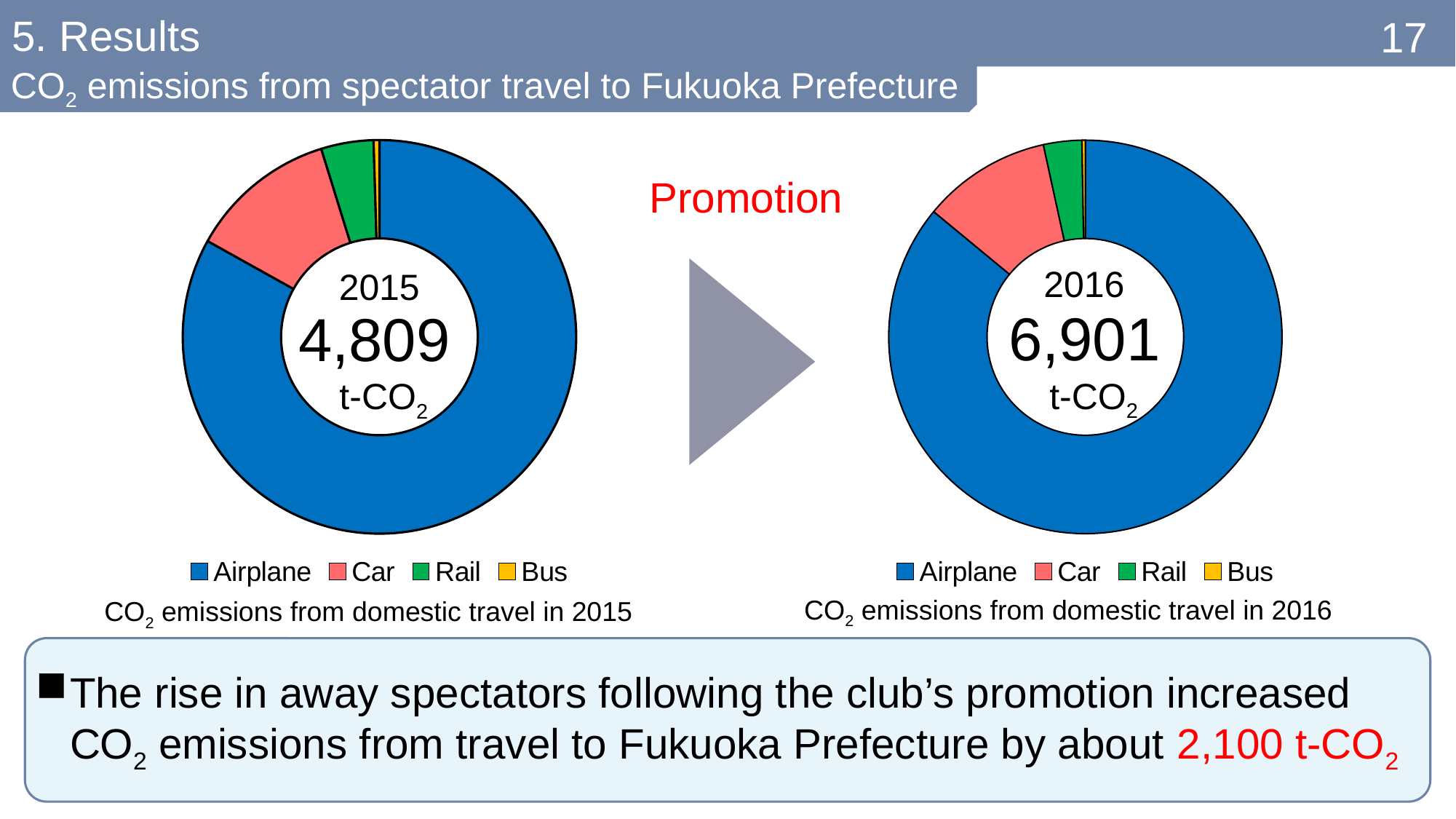
Did total CO2 emissions from domestic travel rise or fall from 2015 to 2016? Rise In the 2016 chart, which has the larger share, Car or Rail? Car What is the caption below the right-hand chart? CO2 emissions from domestic travel in 2016 In the 2016 chart, which travel mode accounts for the smallest share of emissions? Bus In the 2015 chart, which travel mode accounts for the largest share of emissions? Airplane What total CO2 emissions value is shown in the centre of the 2016 chart? 6,901 t-CO2 What is the difference between the total emissions shown for 2016 and 2015? 2,092 t-CO2 How many travel modes does the legend of the 2015 chart list? 4 Which year has the larger total CO2 emissions, 2015 or 2016? 2016 What total CO2 emissions value is shown in the centre of the 2015 chart? 4,809 t-CO2 In the 2015 chart, which colour represents Rail? Green What kind of chart is used to show CO2 emissions from domestic travel in 2015? Pie chart (donut)